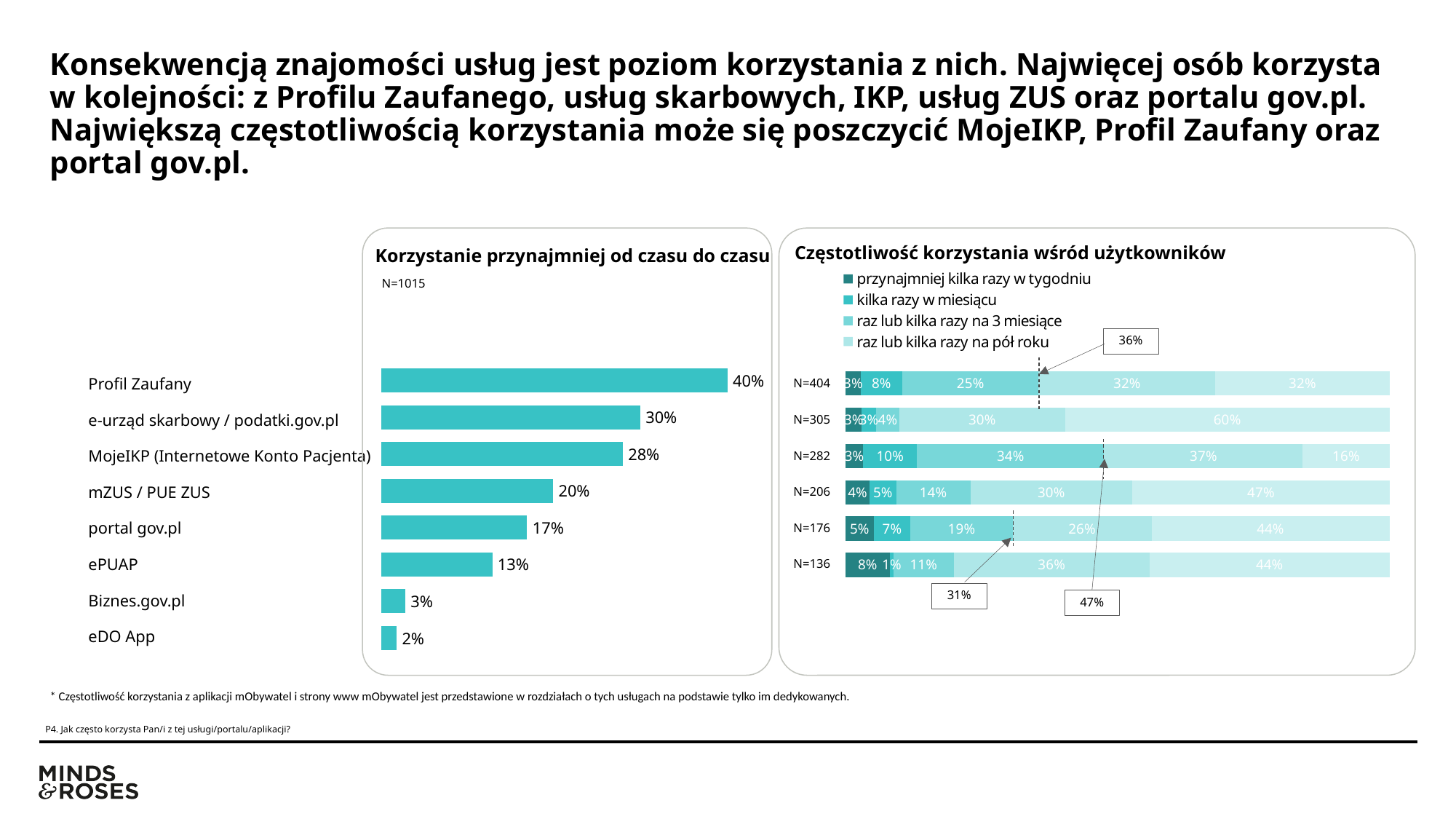
In the chart 'Częstotliwość korzystania wśród użytkowników', what is the value of the 'przynajmniej kilka razy w tygodniu' segment for the N=136 row? 8% In the chart 'Korzystanie przynajmniej od czasu do czasu', which category has the lowest value? eDO App In the chart 'Korzystanie przynajmniej od czasu do czasu', which category has the highest value? Profil Zaufany How many series does the legend of the chart 'Częstotliwość korzystania wśród użytkowników' list? 4 What is the sample size (N) stated on the chart 'Korzystanie przynajmniej od czasu do czasu'? N=1015 In the chart 'Korzystanie przynajmniej od czasu do czasu', what is the difference between the values for e-urząd skarbowy / podatki.gov.pl and ePUAP? 17% What kind of chart is 'Korzystanie przynajmniej od czasu do czasu'? Bar chart In the chart 'Korzystanie przynajmniej od czasu do czasu', what is the value for Profil Zaufany? 40% In the chart 'Korzystanie przynajmniej od czasu do czasu', which is larger: the value for mZUS / PUE ZUS or the value for portal gov.pl? mZUS / PUE ZUS How many categories are shown in the chart 'Korzystanie przynajmniej od czasu do czasu'? 8 In the chart 'Korzystanie przynajmniej od czasu do czasu', what is the value for MojeIKP (Internetowe Konto Pacjenta)? 28% In the chart 'Częstotliwość korzystania wśród użytkowników', what is the value of the 'raz lub kilka razy na pół roku' segment for the N=305 row? 30%